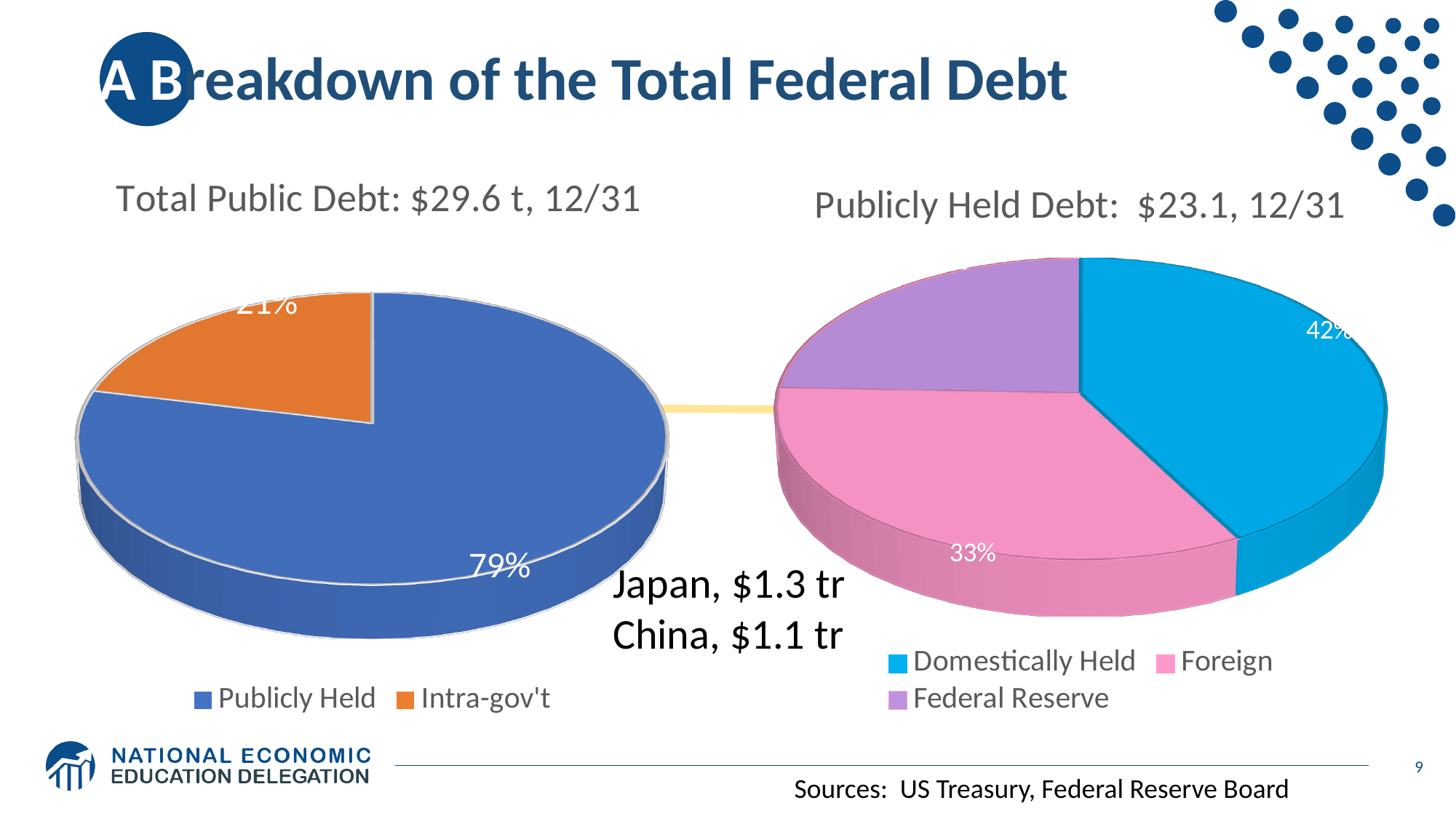
In the Publicly Held Debt chart, which slice is the largest? Domestically Held What type of chart is the Publicly Held Debt chart? Pie chart In the Total Public Debt chart, which slice is the largest? Publicly Held In the Publicly Held Debt chart, which is larger, Domestically Held or Foreign? Domestically Held How many entries does the legend of the Total Public Debt chart list? 2 In the Total Public Debt chart, what is the difference in percentage points between the Publicly Held and Intra-gov't slices? 58 In the Publicly Held Debt chart, what share is Foreign? 33% In the Total Public Debt chart, what share of the pie is Publicly Held? 79% In the Total Public Debt chart, what share of the pie is Intra-gov't? 21% In the Publicly Held Debt chart, which slice is the smallest? Federal Reserve How many slices does the Publicly Held Debt chart have? 3 In the Publicly Held Debt chart, what share is Domestically Held? 42%